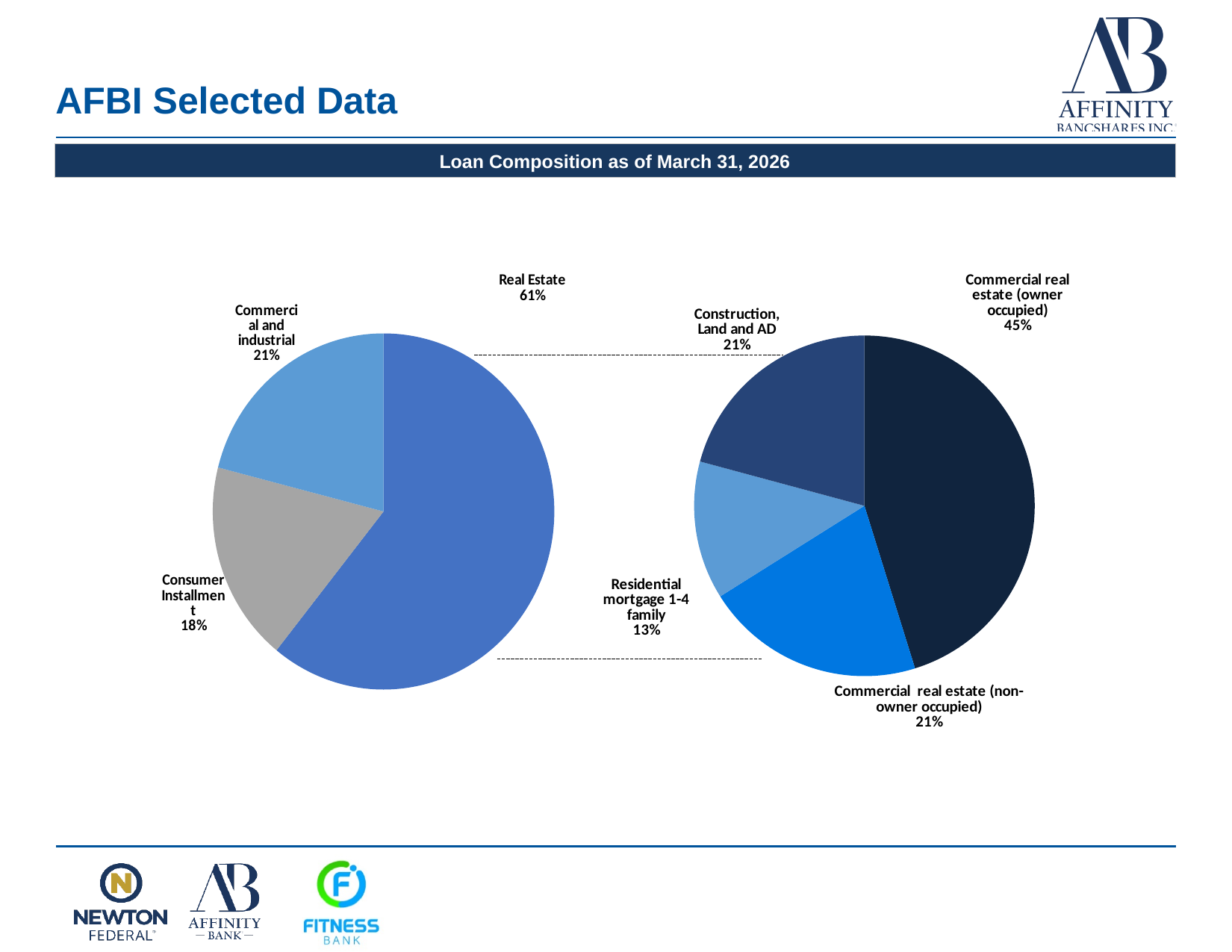
On the right pie chart, what is the difference in percentage points between Commercial real estate (owner occupied) and Commercial real estate (non-owner occupied)? 24 percentage points On the left pie chart, what share of loans is Real Estate? 61% On the right pie chart, what share is Construction, Land and AD? 21% On the right pie chart, which category has the smallest share? Residential mortgage 1-4 family On the left pie chart, which category has the smallest share? Consumer Installment On the left pie chart, what share is Consumer Installment? 18% On the left pie chart, which category has the largest share? Real Estate On the left pie chart, how many slices are there? 3 On the left pie chart, what share is Commercial and industrial? 21% On the right pie chart, what share is Residential mortgage 1-4 family? 13% What type of charts are shown on the slide? Pie charts On the right pie chart, what share is Commercial real estate (owner occupied)? 45%